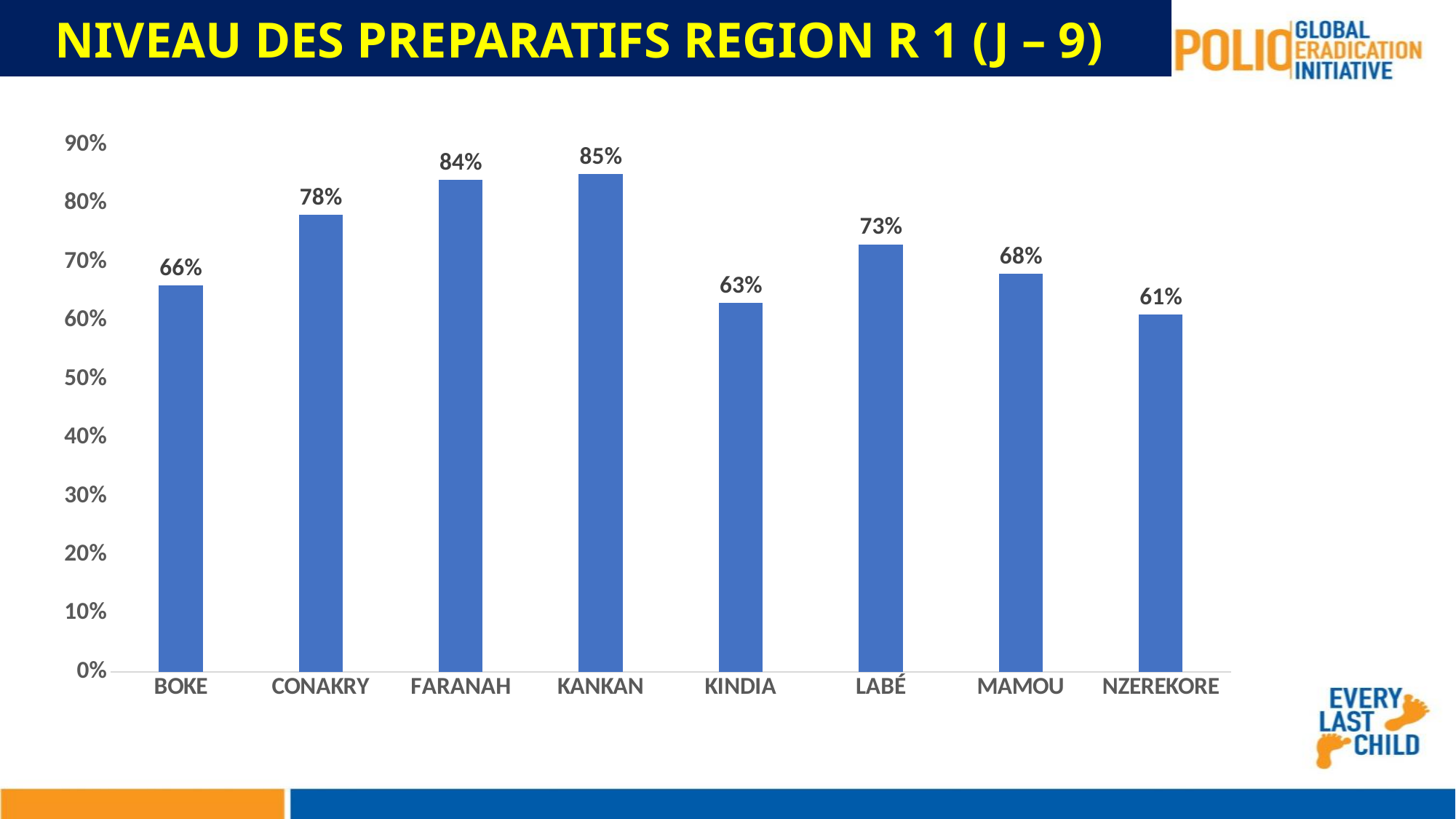
What kind of chart is shown on the slide? bar chart Which is larger, the value for CONAKRY or the value for LABÉ? CONAKRY Is the value for FARANAH greater or less than 80%? greater What is the difference between the values for KANKAN and BOKE? 19% Which region has the highest value? KANKAN What is the value for KINDIA? 63% What is the value for MAMOU? 68% Which region has the lowest value? NZEREKORE How many regions are shown on the x axis? 8 What is the title of the slide? NIVEAU DES PREPARATIFS REGION R 1 (J – 9) What is the difference between the values for LABÉ and NZEREKORE? 12% What is the value for CONAKRY? 78%